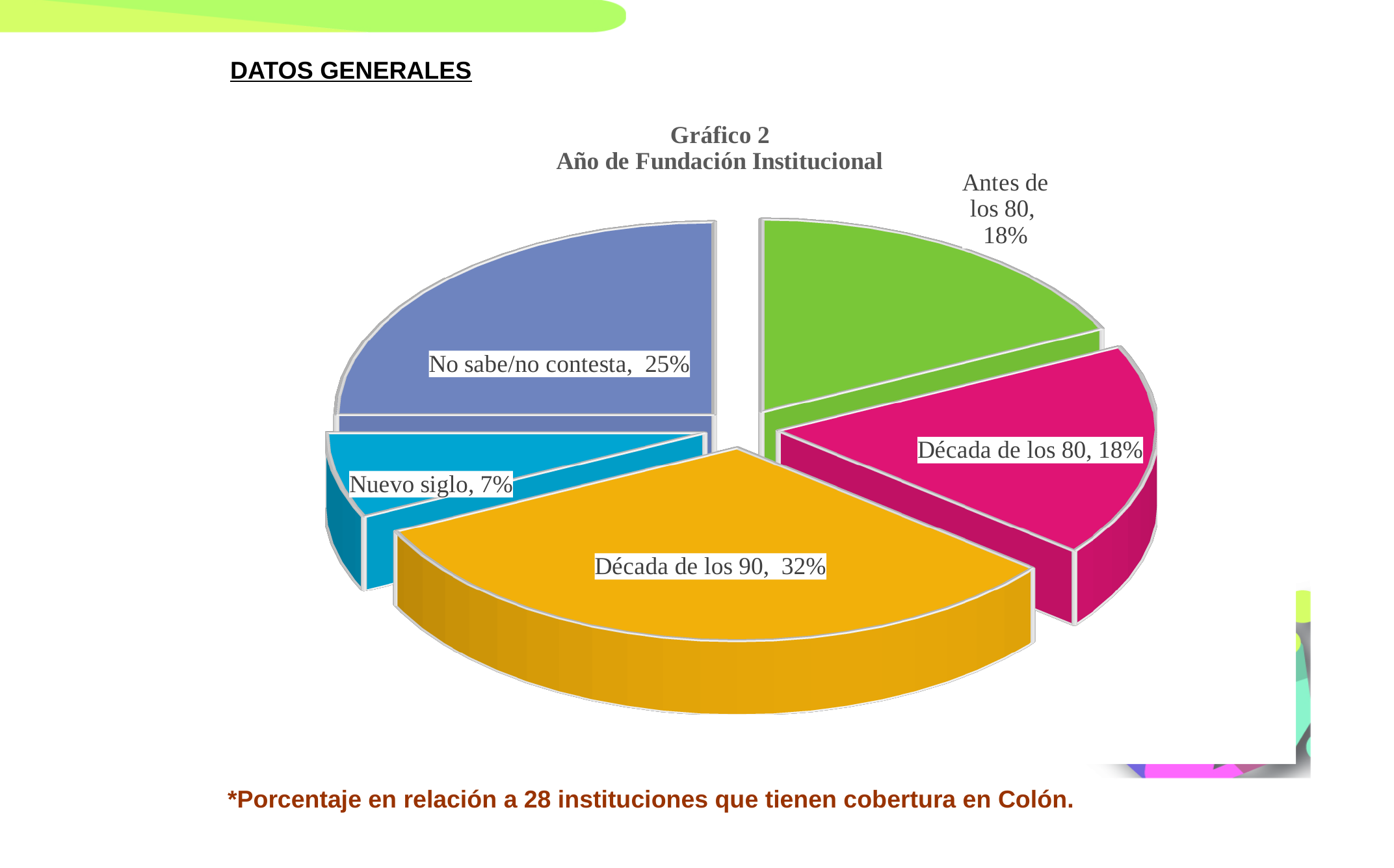
What percentage is shown for Década de los 90? 32% What percentage is shown for No sabe/no contesta? 25% Which category has the smallest share of the pie? Nuevo siglo Which is larger, the share for No sabe/no contesta or the share for Década de los 80? No sabe/no contesta What is the title of the chart? Gráfico 2 Año de Fundación Institucional What percentage is shown for Nuevo siglo? 7% Which category has the largest share of the pie? Década de los 90 How many slices does the pie chart have? 5 What is the difference in percentage points between Década de los 90 and No sabe/no contesta? 7 What colour is the Década de los 90 slice? Orange What percentage is shown for Antes de los 80? 18% What type of chart is shown on the slide? Pie chart